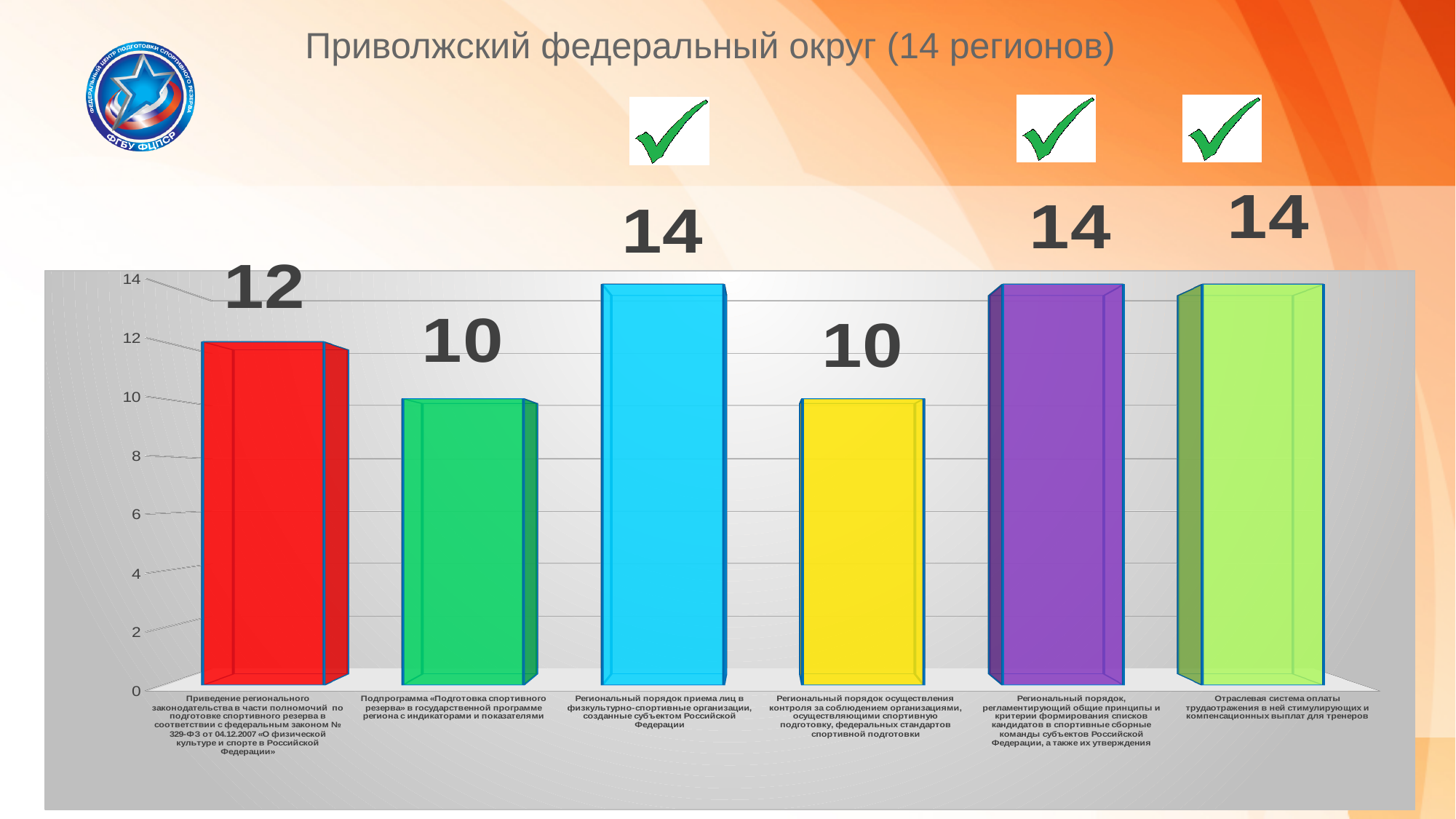
What is the value of the bar for «Приведение регионального законодательства в части полномочий по подготовке спортивного резерва...»? 12 Which is larger: the value for «Приведение регионального законодательства...» or the value for «Подпрограмма «Подготовка спортивного резерва»...»? Приведение регионального законодательства... What is the lowest value shown on the chart? 10 What kind of chart is shown on the slide? bar chart How many bars reach the maximum value of 14? 3 What is the difference between the value for «Отраслевая система оплаты труда...» and the value for «Региональный порядок осуществления контроля за соблюдением организациями... федеральных стандартов спортивной подготовки»? 4 What is the value of the bar for «Региональный порядок приема лиц в физкультурно-спортивные организации, созданные субъектом Российской Федерации»? 14 Is the value for «Приведение регионального законодательства...» greater or less than 10? greater What is the value of the bar for «Отраслевая система оплаты труда, отражения в ней стимулирующих и компенсационных выплат для тренеров»? 14 What is the value of the bar for «Подпрограмма «Подготовка спортивного резерва» в государственной программе региона с индикаторами и показателями»? 10 How many categories (bars) are shown on the chart? 6 What is the difference between the value for «Региональный порядок приема лиц в физкультурно-спортивные организации...» and the value for «Приведение регионального законодательства...»? 2